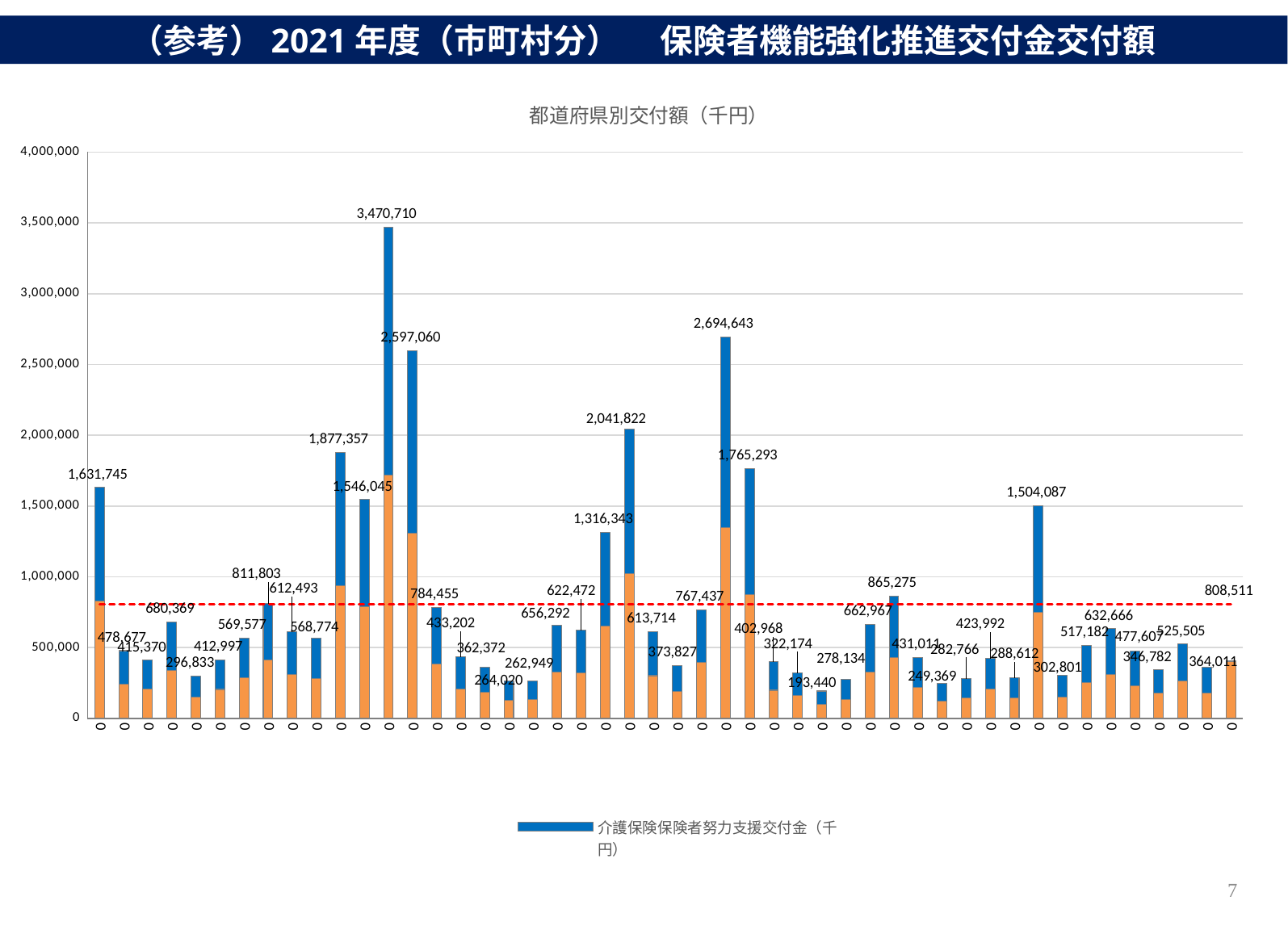
What type of chart is shown on the slide? Bar chart (stacked) What is the title of the chart? 都道府県別交付額（千円） How many bars have a labeled total greater than 2,000,000? 4 What is the second-highest total value labeled in the chart? 2,694,643 Is the tallest bar in the chart greater or less than 3,000,000? greater How many bars (prefectures) are plotted in the chart? 47 What is the lowest total value labeled on any bar in the chart? 193,440 What is the difference between the highest labeled bar (3,470,710) and the lowest labeled bar (193,440)? 3,277,270 What is the highest total value labeled on any bar in the chart? 3,470,710 What is the difference between the two highest labeled bars, 3,470,710 and 2,694,643? 776,067 What value is labeled on the red dashed horizontal line? 808,511 What series name is shown in the chart legend? 介護保険保険者努力支援交付金（千円）